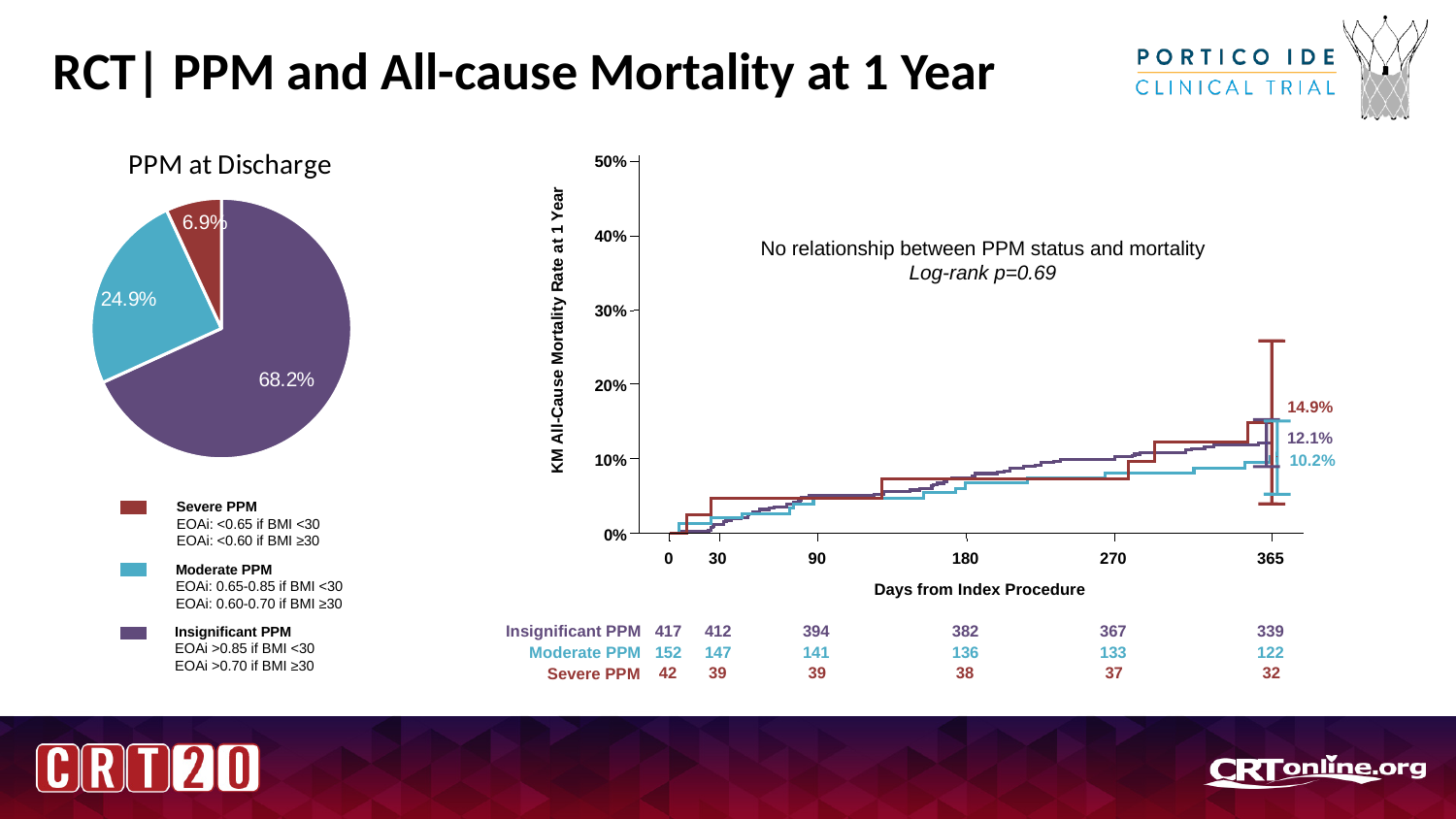
In the KM All-Cause Mortality chart, what is the log-rank p-value shown? 0.69 What kind of chart is the PPM at Discharge chart? Pie chart In the PPM at Discharge pie chart, what share is Moderate PPM? 24.9% In the KM All-Cause Mortality chart, which group has the higher mortality rate at 365 days, Insignificant PPM or Moderate PPM? Insignificant PPM In the PPM at Discharge pie chart, which category has the largest slice? Insignificant PPM In the KM All-Cause Mortality chart, what is the mortality rate for Moderate PPM at 365 days? 10.2% In the KM All-Cause Mortality chart, what is the difference between the Severe PPM and Moderate PPM mortality rates at 365 days? 4.7% In the PPM at Discharge pie chart, which category has the smallest slice? Severe PPM In the KM All-Cause Mortality chart, what is the mortality rate for Severe PPM at 365 days? 14.9% In the PPM at Discharge pie chart, what share is Insignificant PPM? 68.2% How many slices does the PPM at Discharge pie chart have? 3 In the PPM at Discharge pie chart, what share is Severe PPM? 6.9%